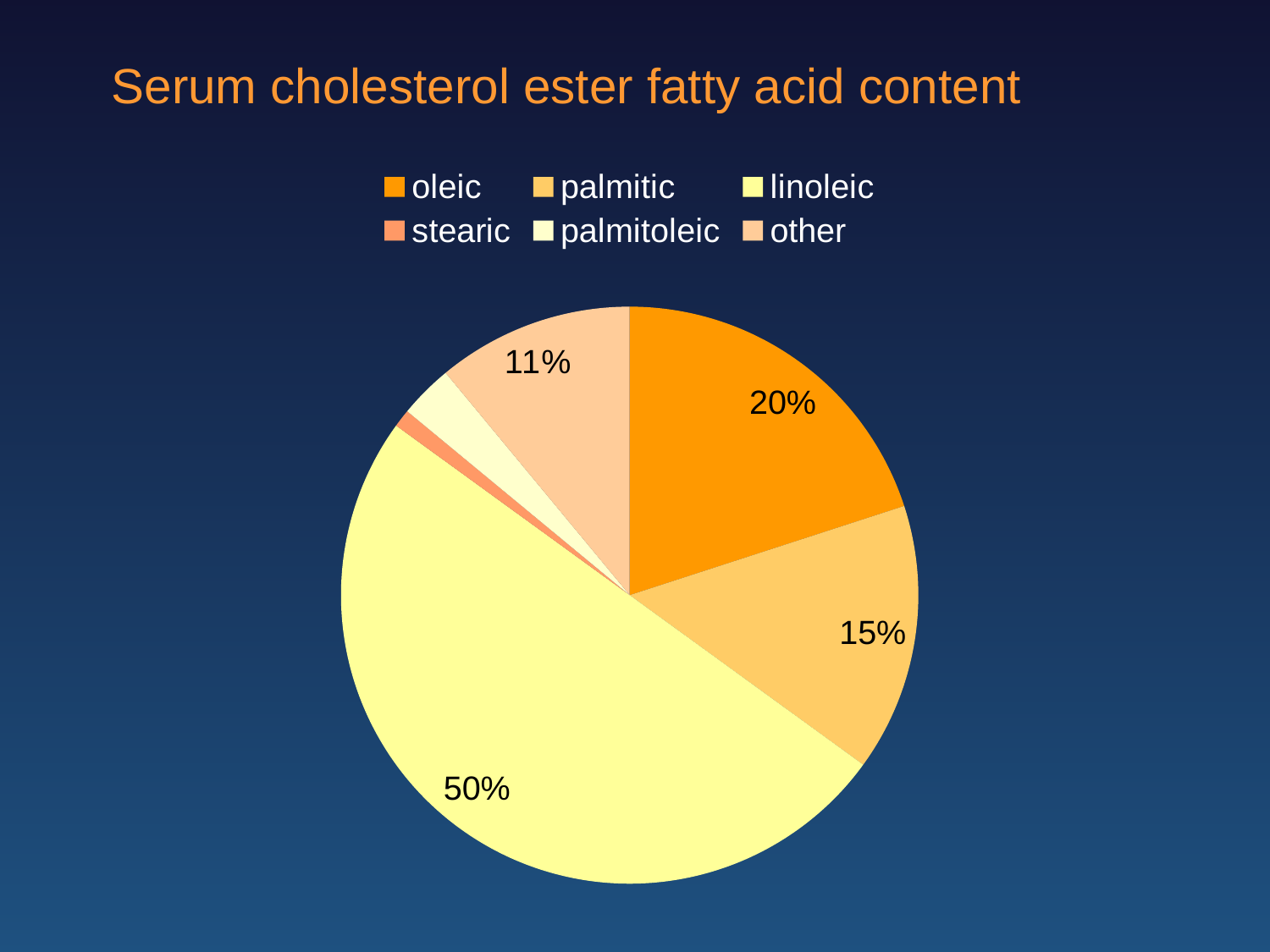
What is the value shown for palmitic? 15% Which fatty acid has the smallest slice of the pie? stearic Which fatty acid has the largest slice of the pie? linoleic By how many percentage points does linoleic exceed oleic? 30 What kind of chart is shown on the slide? pie chart What is the value shown for oleic? 20% By how many percentage points does oleic exceed palmitic? 5 Which slice is larger, oleic or palmitic? oleic How many categories does the pie chart show? 6 What is the value shown for the 'other' slice? 11% What percentage of the pie does linoleic account for? 50% What is the title of the chart? Serum cholesterol ester fatty acid content